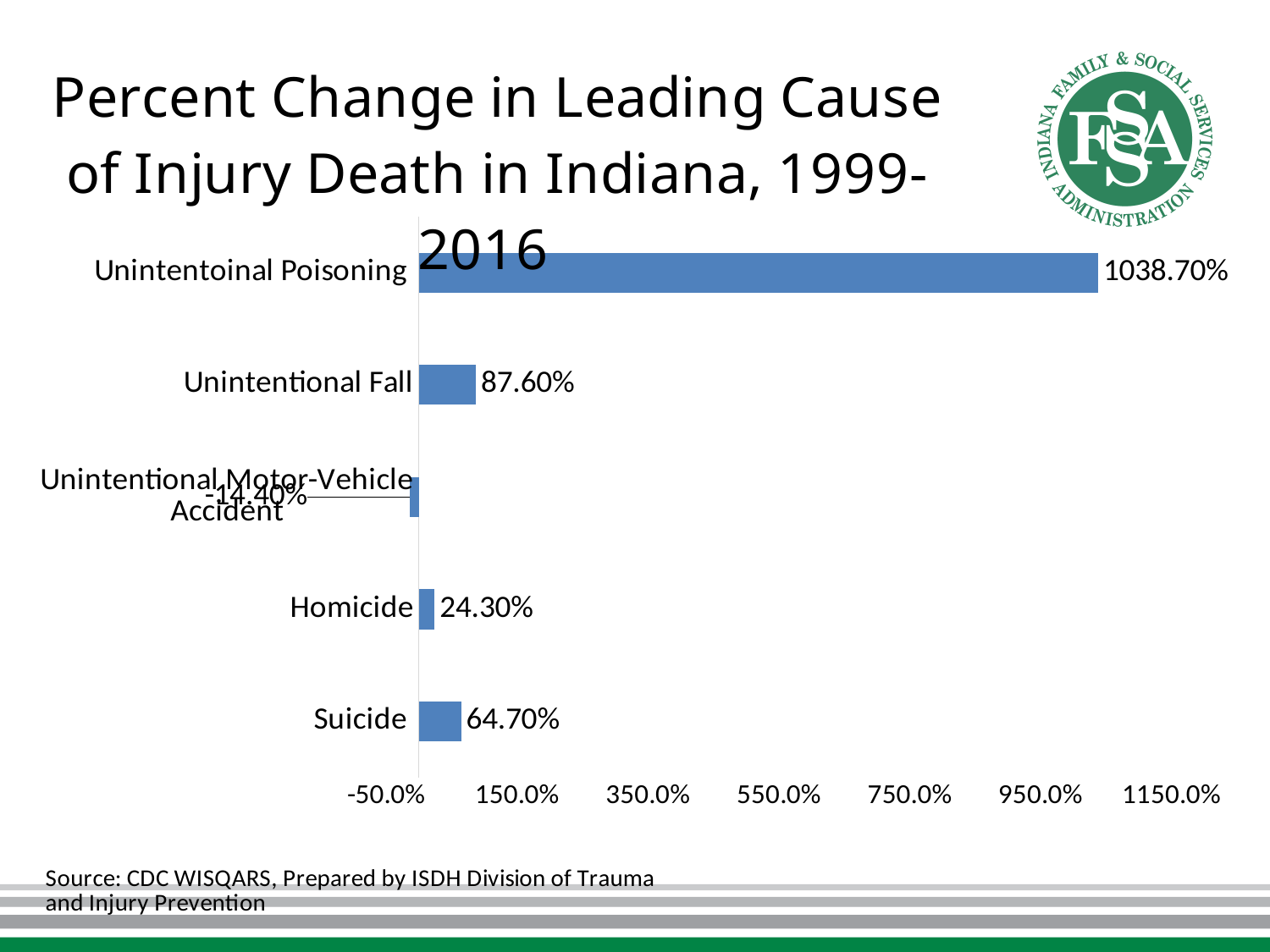
What is the percent change for Unintentional Motor-Vehicle Accident? -14.40% Which has a larger percent change, Suicide or Homicide? Suicide Which cause of injury death has the highest percent change? Unintentional Poisoning What kind of chart is shown on the slide? Bar chart How many causes of injury death are shown in the chart? 5 Which cause of injury death has the lowest percent change? Unintentional Motor-Vehicle Accident What is the percent change for Unintentional Fall? 87.60% What is the percent change for Suicide? 64.70% What is the difference between the percent change for Unintentional Fall and Suicide? 22.90% What is the difference between the percent change for Suicide and Homicide? 40.40% What is the percent change for Unintentional Poisoning? 1038.70% What is the percent change for Homicide? 24.30%